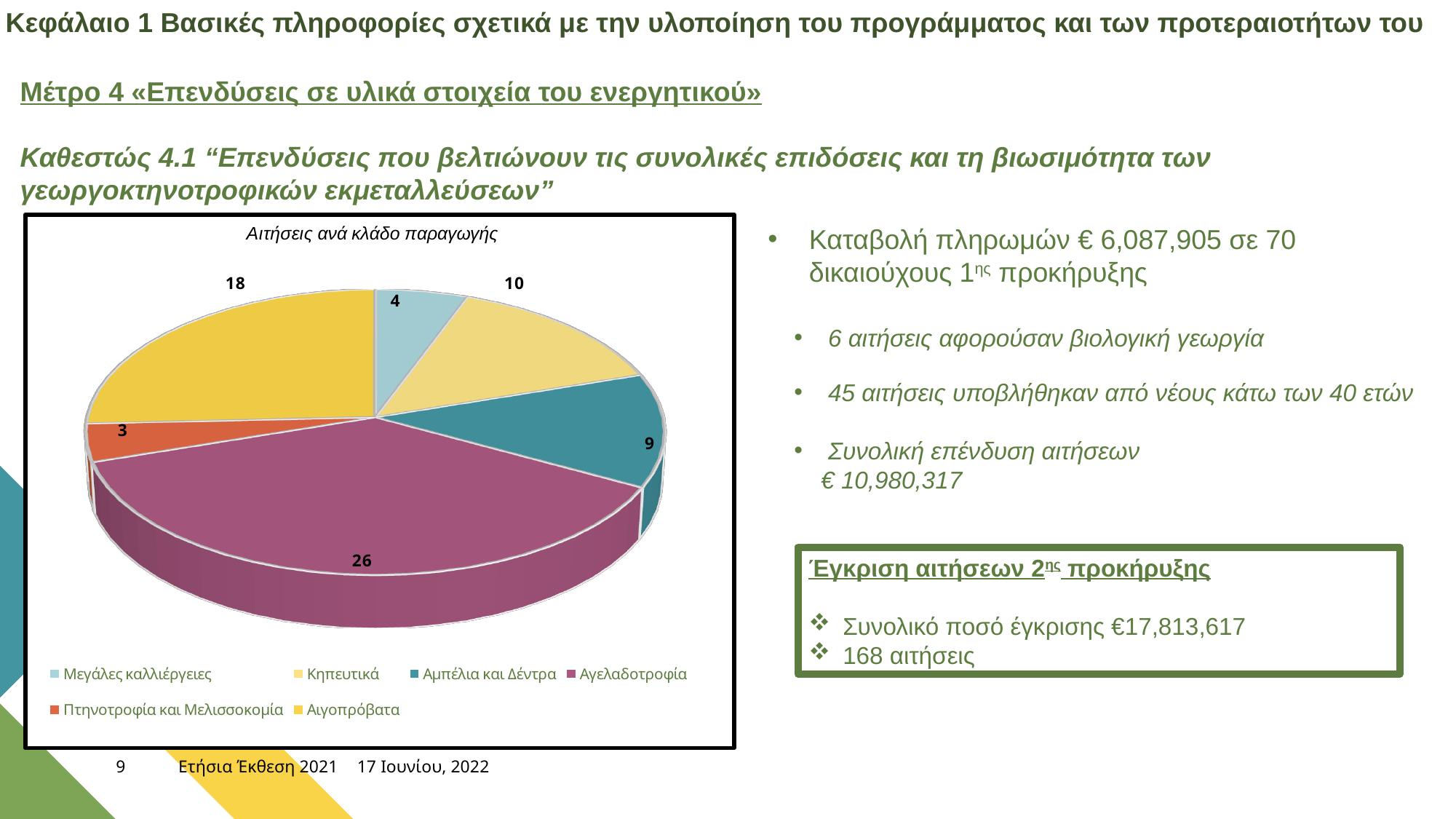
What is the value for Αιγοπρόβατα? 18 What is the value for Αγελαδοτροφία? 26 What type of chart is shown on the slide? Pie chart Which category has the largest slice? Αγελαδοτροφία Which category has the smallest slice? Πτηνοτροφία και Μελισσοκομία What is the total of all slices in the pie chart? 70 What is the title of the chart? Αιτήσεις ανά κλάδο παραγωγής What is the difference between the values for Αγελαδοτροφία and Αιγοπρόβατα? 8 How many slices does the pie chart have? 6 What is the value for Κηπευτικά? 10 Which is larger, the value for Κηπευτικά or the value for Αμπέλια και Δέντρα? Κηπευτικά What is the value for Πτηνοτροφία και Μελισσοκομία? 3